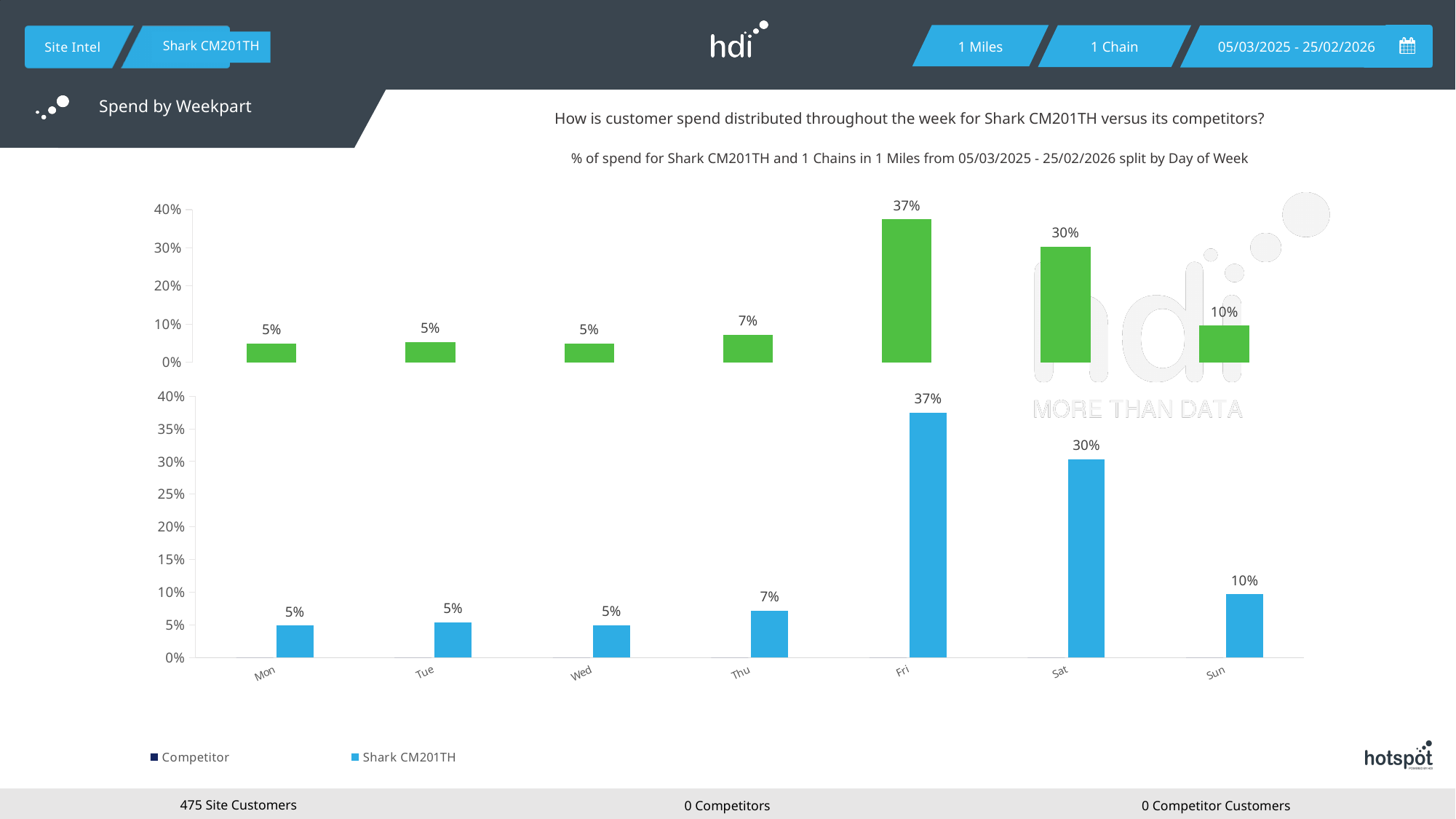
In the lower blue bar chart, which day has the highest value? Fri What kind of chart is the lower chart on the slide? bar chart In the lower blue bar chart, what is the value for Sun? 10% How many day categories are shown on the x axis of the lower blue bar chart? 7 How many series does the legend of the lower chart list? 2 In the lower blue bar chart, which is larger, the value for Sat or the value for Sun? Sat In the lower blue bar chart, what is the value for Thu? 7% In the lower blue bar chart, what is the difference between the values for Fri and Sat? 7% In the upper green bar chart, what is the highest value labelled on a bar? 37% In the lower blue bar chart, is the value for Sat greater or less than 25%? greater What are the two series names listed in the legend of the lower chart? Competitor and Shark CM201TH In the lower blue bar chart, what is the value for Fri? 37%